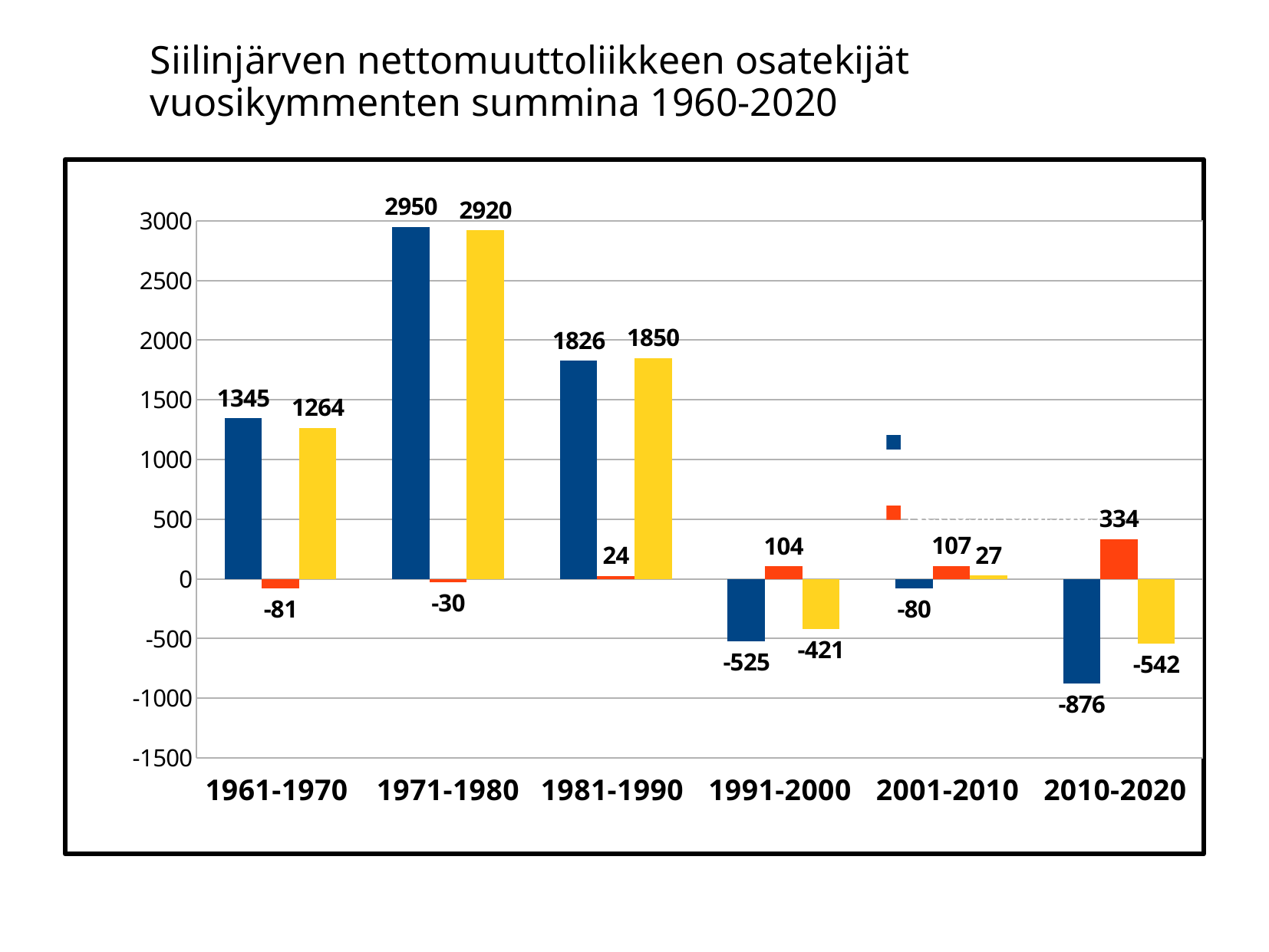
What is the value of the orange bar for 2010-2020? 334 Do the dark blue bar values rise or fall from 1971-1980 to 2010-2020? fall Which decade has the highest dark blue bar? 1971-1980 What type of chart is shown on the slide? bar chart What is the difference between the dark blue bar and the yellow bar for 1961-1970? 81 What is the value of the dark blue bar for 1991-2000? -525 What is the value of the dark blue bar for 1971-1980? 2950 Which decade has the lowest yellow bar? 2010-2020 What is the value of the yellow bar for 1981-1990? 1850 What is the title of the slide? Siilinjärven nettomuuttoliikkeen osatekijät vuosikymmenten summina 1960-2020 Which is larger for 1981-1990, the dark blue bar or the yellow bar? the yellow bar How many decade categories are shown on the x axis? 6